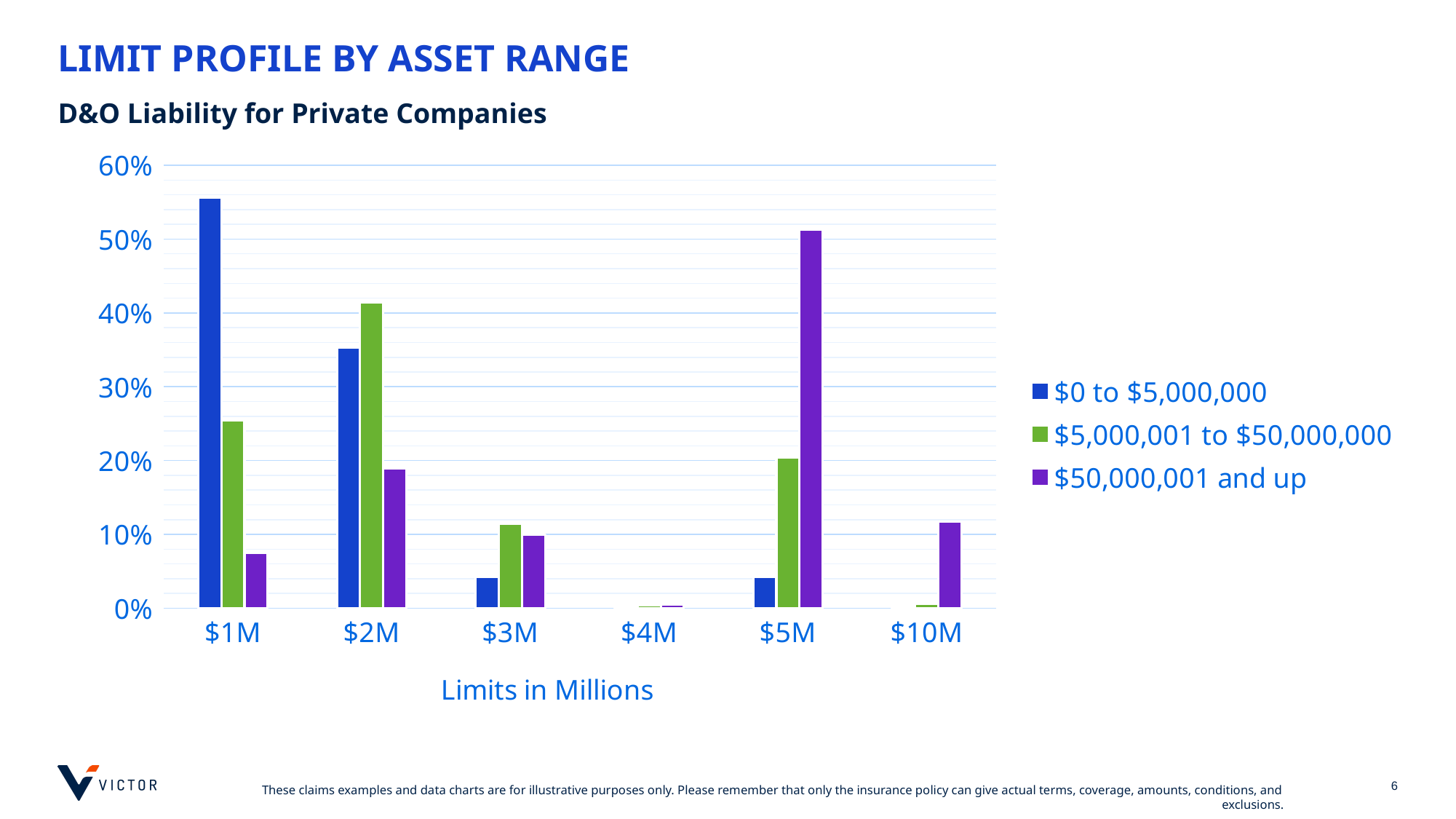
How many series does the legend list? 3 Is the value for the $5,000,001 to $50,000,000 series at $5M greater or less than 30%? less Is the value for the $0 to $5,000,000 series at $1M greater or less than 50%? greater How many limit categories are shown on the x axis? 6 Is the value for the $50,000,001 and up series at $5M greater or less than 40%? greater What is the title of the x axis? Limits in Millions For the $5,000,001 to $50,000,000 series, which limit has the highest value? $2M At the $2M limit, which series has the larger value: $0 to $5,000,000 or $5,000,001 to $50,000,000? $5,000,001 to $50,000,000 At the $1M limit, which series has the larger value: $0 to $5,000,000 or $5,000,001 to $50,000,000? $0 to $5,000,000 What kind of chart is shown on the slide? Bar chart For the $0 to $5,000,000 series, which limit has the highest value? $1M For the $50,000,001 and up series, which limit has the highest value? $5M